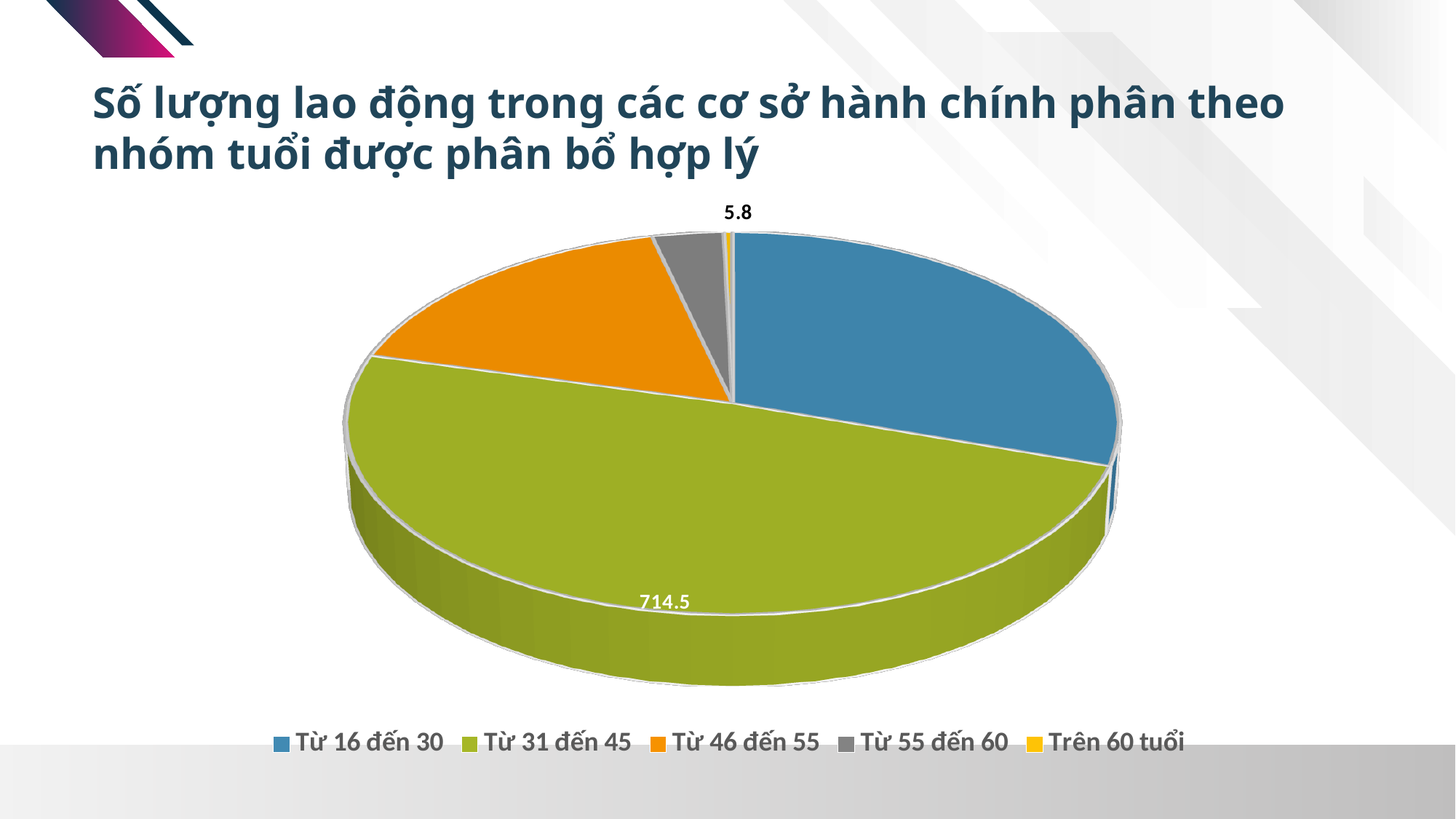
Which age group has the largest slice of the pie? Từ 31 đến 45 Which slice is larger, 'Từ 46 đến 55' or 'Từ 55 đến 60'? Từ 46 đến 55 What is the value shown for the 'Trên 60 tuổi' slice? 5.8 Which slice is larger, 'Từ 16 đến 30' or 'Từ 46 đến 55'? Từ 16 đến 30 What is the difference between the values for 'Từ 31 đến 45' and 'Trên 60 tuổi'? 708.7 How many slices does the pie chart have? 5 How many entries does the legend list? 5 Which legend entry is shown in orange? Từ 46 đến 55 What colour is the 'Từ 16 đến 30' slice? blue What is the value shown for the 'Từ 31 đến 45' slice? 714.5 Which age group has the smallest slice of the pie? Trên 60 tuổi What kind of chart is shown on the slide? pie chart